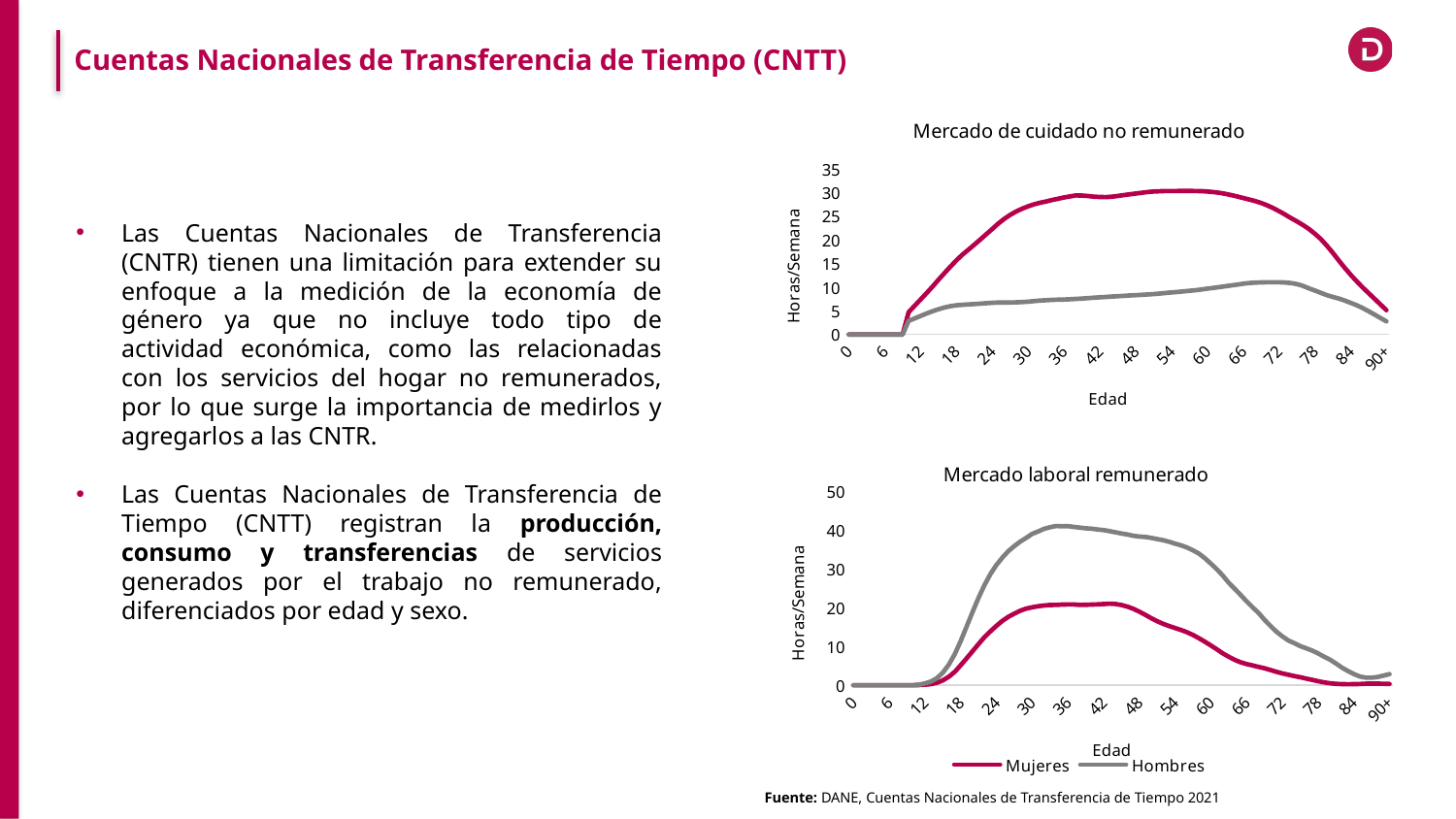
In the 'Mercado laboral remunerado' chart, is the value for Hombres at age 36 greater or less than 30? greater In the 'Mercado laboral remunerado' chart, is the value for Mujeres at age 36 greater or less than 30? less How many series does the legend list for the 'Mercado laboral remunerado' chart? 2 What kind of chart is the 'Mercado de cuidado no remunerado' chart? line chart In the 'Mercado laboral remunerado' chart, which series is higher at age 30, Mujeres or Hombres? Hombres In the 'Mercado de cuidado no remunerado' chart, is the value for Hombres at age 54 greater or less than 10? less What is the y-axis label of the 'Mercado laboral remunerado' chart? Horas/Semana In the 'Mercado de cuidado no remunerado' chart, which series is higher at age 48, Mujeres or Hombres? Mujeres In the 'Mercado laboral remunerado' chart, does the Hombres line rise or fall from age 12 to 36? rise In the 'Mercado de cuidado no remunerado' chart, does the Mujeres line rise or fall from age 60 to 90+? fall